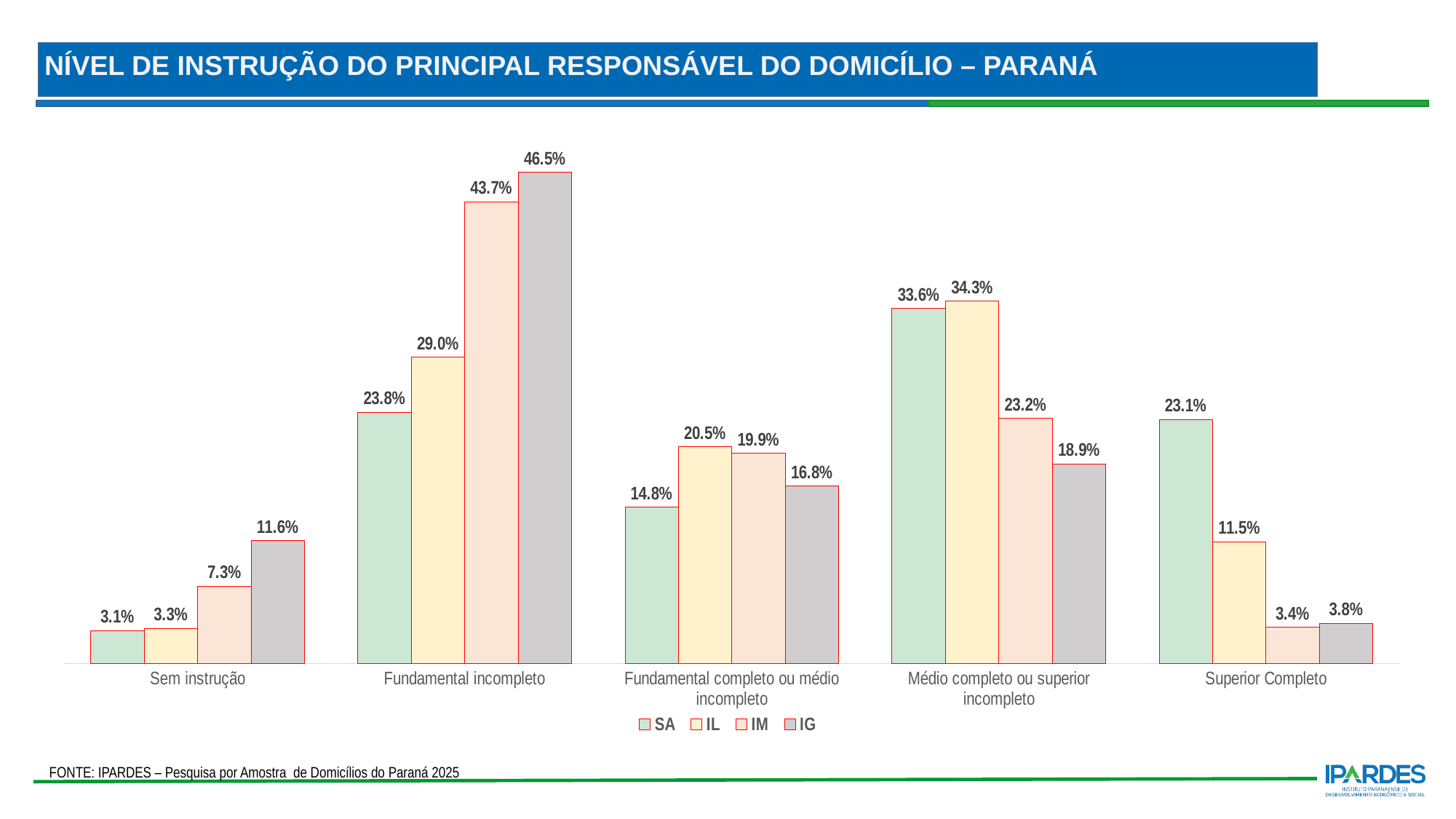
In the Médio completo ou superior incompleto category, which is larger: the SA value or the IG value? SA How many series does the legend list? 4 What is the value for SA in the Superior Completo category? 23.1% What is the value for IM in the Sem instrução category? 7.3% What are the series names listed in the legend? SA, IL, IM, IG How many categories are shown on the x axis? 5 What is the difference between the IL and IM values in the Superior Completo category? 8.1% What is the difference between the IG and SA values in the Fundamental incompleto category? 22.7% Which category has the highest value for the IM series? Fundamental incompleto What is the value for IG in the Fundamental incompleto category? 46.5% What kind of chart is shown on the slide? Bar chart Which category has the lowest value for the SA series? Sem instrução